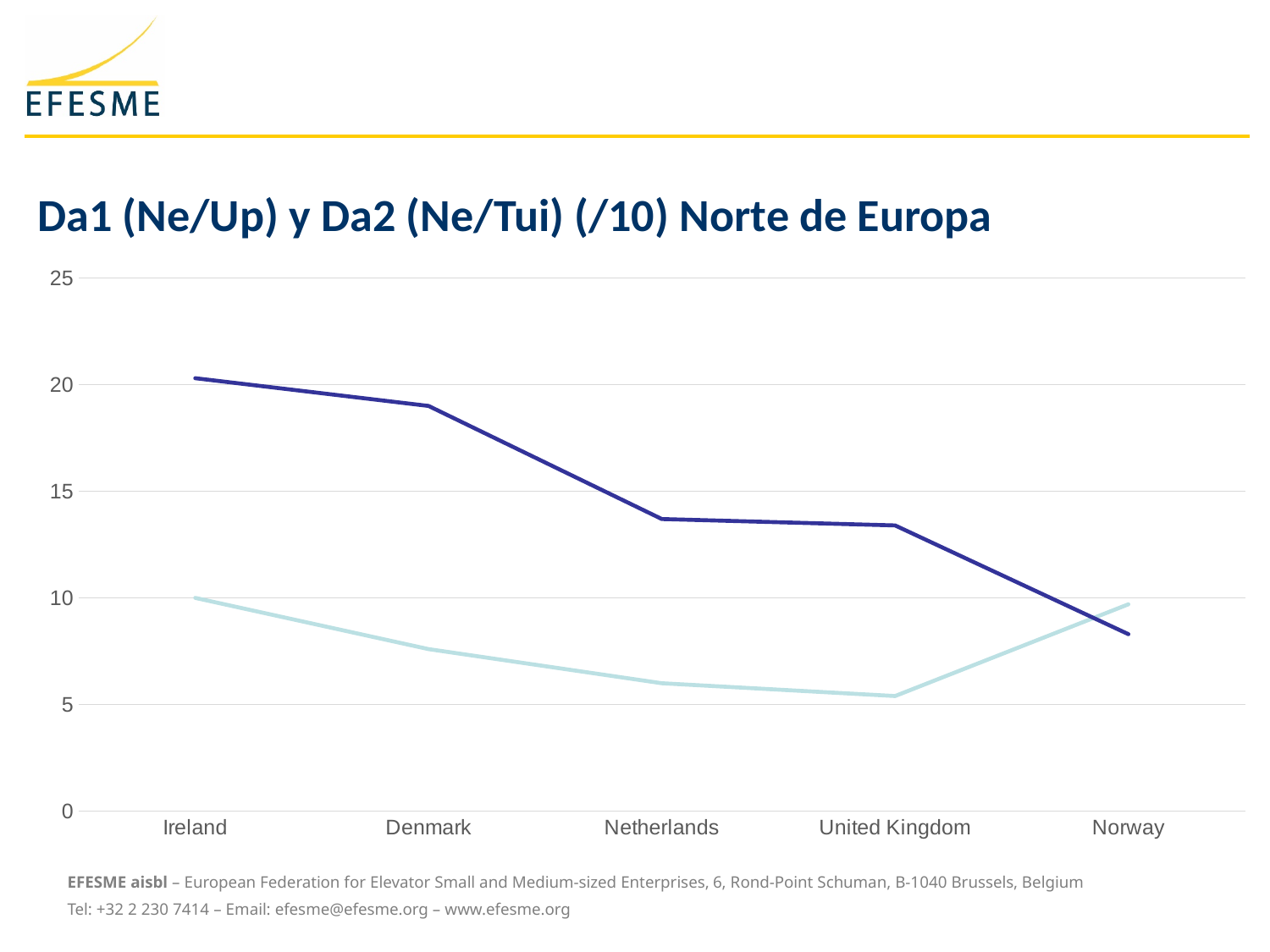
How many countries are shown on the x axis of the chart? 5 Is the dark blue line's value for Denmark greater or less than 15? greater Is the light blue line's value for Denmark greater or less than 10? less For the light blue line, which country has the lowest value? United Kingdom What is the title of the chart? Da1 (Ne/Up) y Da2 (Ne/Tui) (/10) Norte de Europa At Norway, which line has the larger value, the dark blue line or the light blue line? light blue line How many lines are plotted on the chart? 2 For the dark blue line, which country has the highest value? Ireland Does the dark blue line rise or fall from Ireland to Norway? fall What kind of chart is shown on the slide? line chart For the dark blue line, which country has the lowest value? Norway Is the dark blue line's value for Netherlands greater or less than 15? less